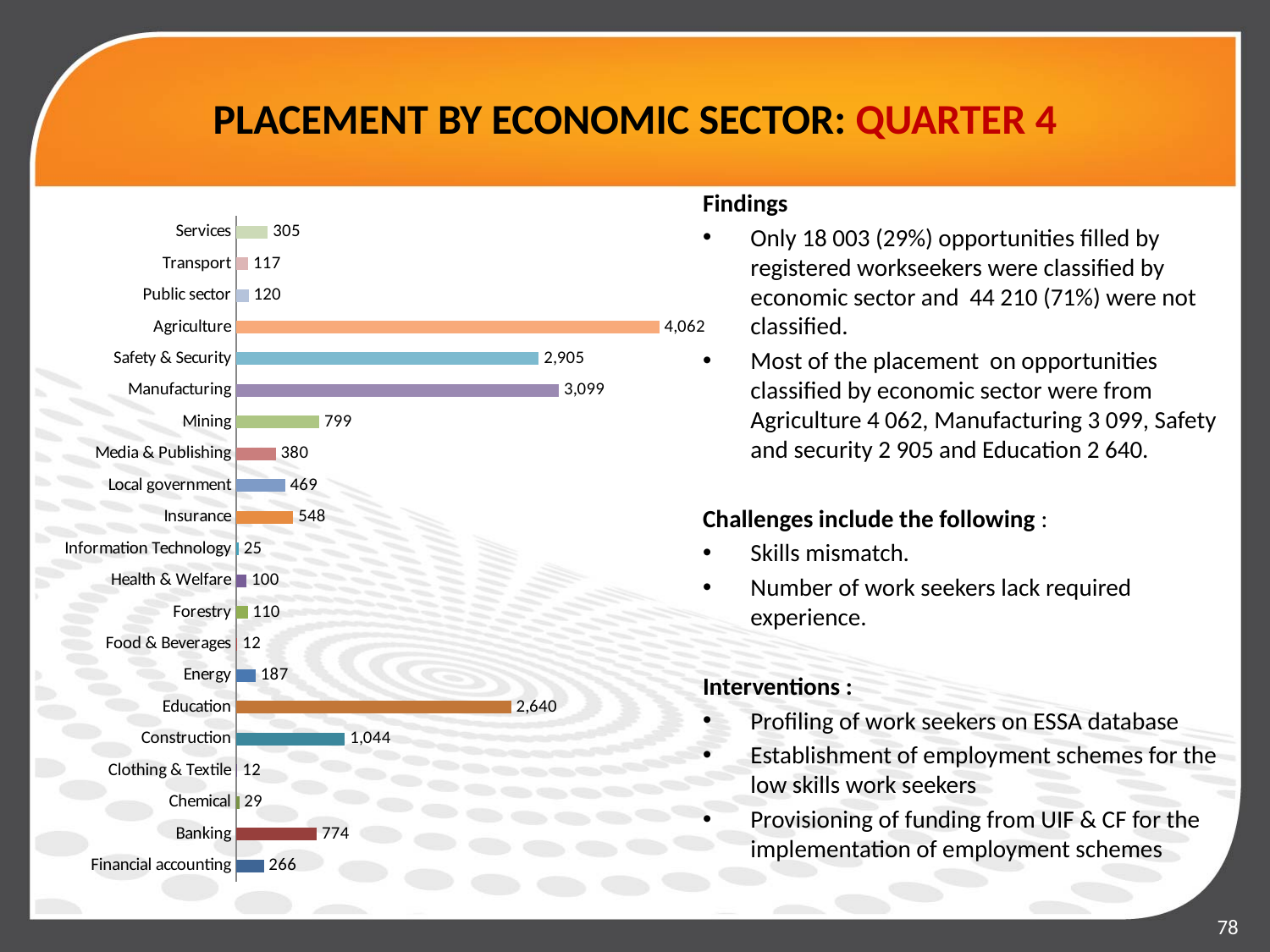
Which economic sector has the highest placement value? Agriculture What is the value for Agriculture? 4,062 What is the difference between the values for Agriculture and Education? 1,422 What is the title of the slide containing the chart? PLACEMENT BY ECONOMIC SECTOR: QUARTER 4 Which is larger, the value for Mining or the value for Banking? Mining What is the difference between the values for Manufacturing and Safety & Security? 194 What is the value for Information Technology? 25 How many economic sectors are shown in the chart? 21 What is the value for Construction? 1,044 What is the value for Banking? 774 What kind of chart is shown on the slide? Bar chart Which is larger, the value for Insurance or the value for Local government? Insurance